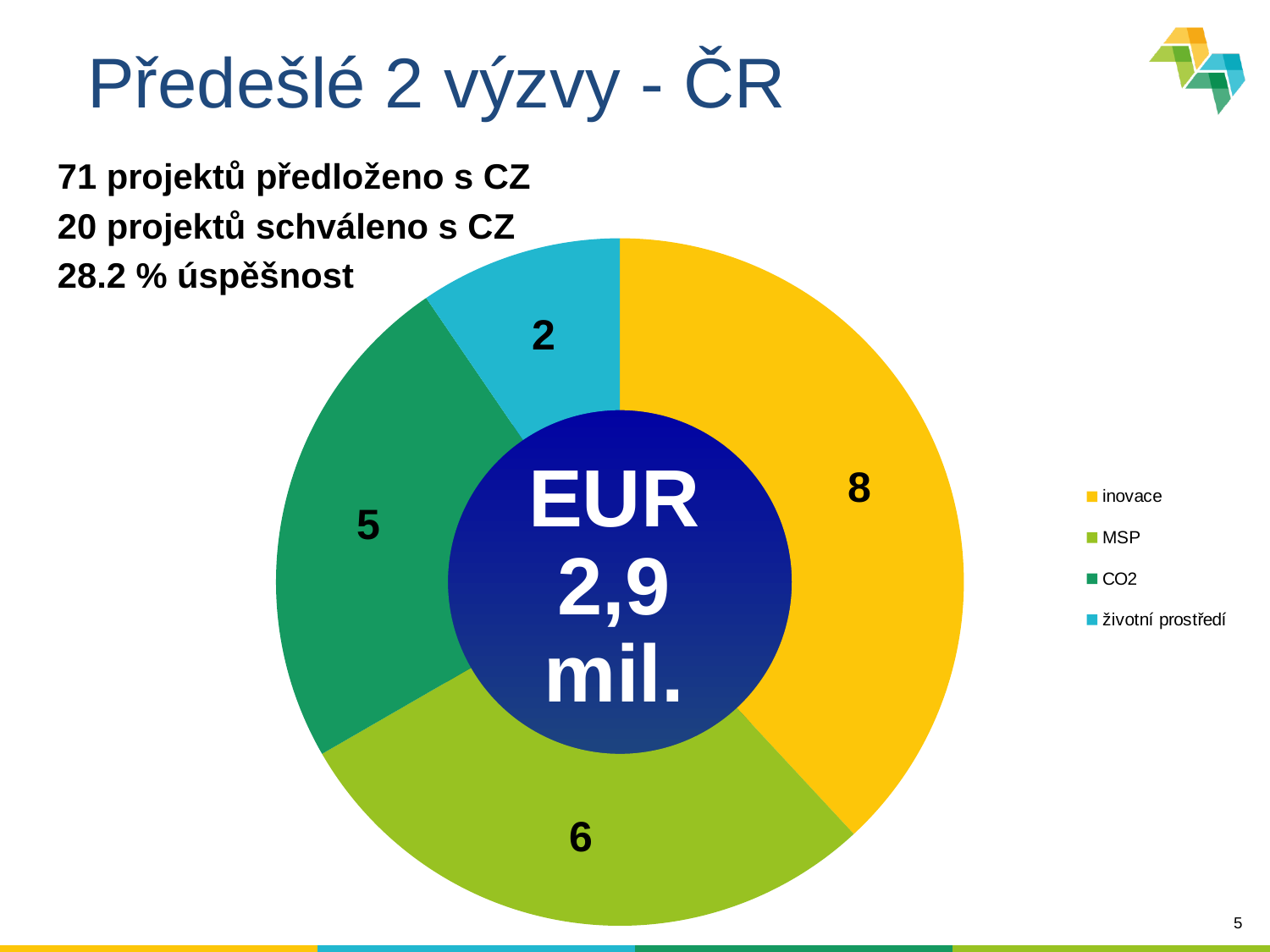
What text is shown in the centre of the pie chart? EUR 2,9 mil. What kind of chart is shown on the slide? doughnut chart Which is larger, the value for MSP or the value for CO2? MSP Which category has the smallest slice in the pie chart? životní prostředí Which category has the largest slice in the pie chart? inovace What is the value for životní prostředí in the pie chart? 2 What is the value for CO2 in the pie chart? 5 What is the difference between the values for inovace and CO2? 3 What is the value for MSP in the pie chart? 6 What is the value for inovace in the pie chart? 8 How many categories does the pie chart show? 4 What is the total of all the slice values in the pie chart? 21